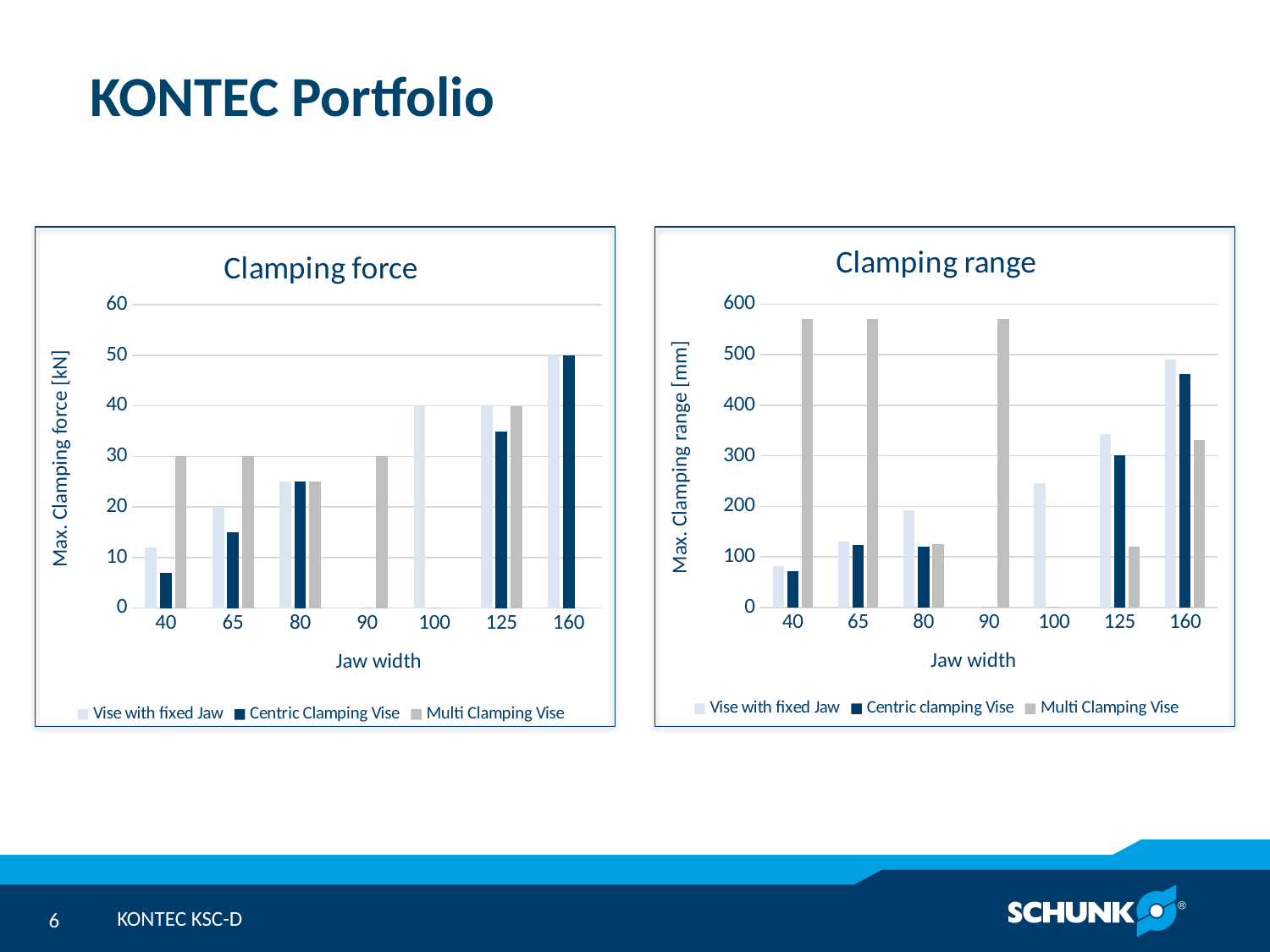
In the Clamping range chart, at jaw width 80, which is larger: Vise with fixed Jaw or Centric clamping Vise? Vise with fixed Jaw What kind of chart is the Clamping force chart? Bar chart In the Clamping force chart, at jaw width 125, which is larger: Vise with fixed Jaw or Centric Clamping Vise? Vise with fixed Jaw In the Clamping range chart, is the value for Multi Clamping Vise at jaw width 40 greater or less than 500? greater In the Clamping force chart, what is the value for Multi Clamping Vise at jaw width 40? 30 How many series does the legend of the Clamping range chart list? 3 In the Clamping force chart, what is the value for Vise with fixed Jaw at jaw width 100? 40 How many jaw width categories are shown on the x axis of the Clamping force chart? 7 In the Clamping force chart, what is the value for Centric Clamping Vise at jaw width 160? 50 In the Clamping range chart, is the value for Vise with fixed Jaw at jaw width 100 greater or less than 300? less In the Clamping force chart, what is the difference between the Vise with fixed Jaw values at jaw widths 100 and 65? 20